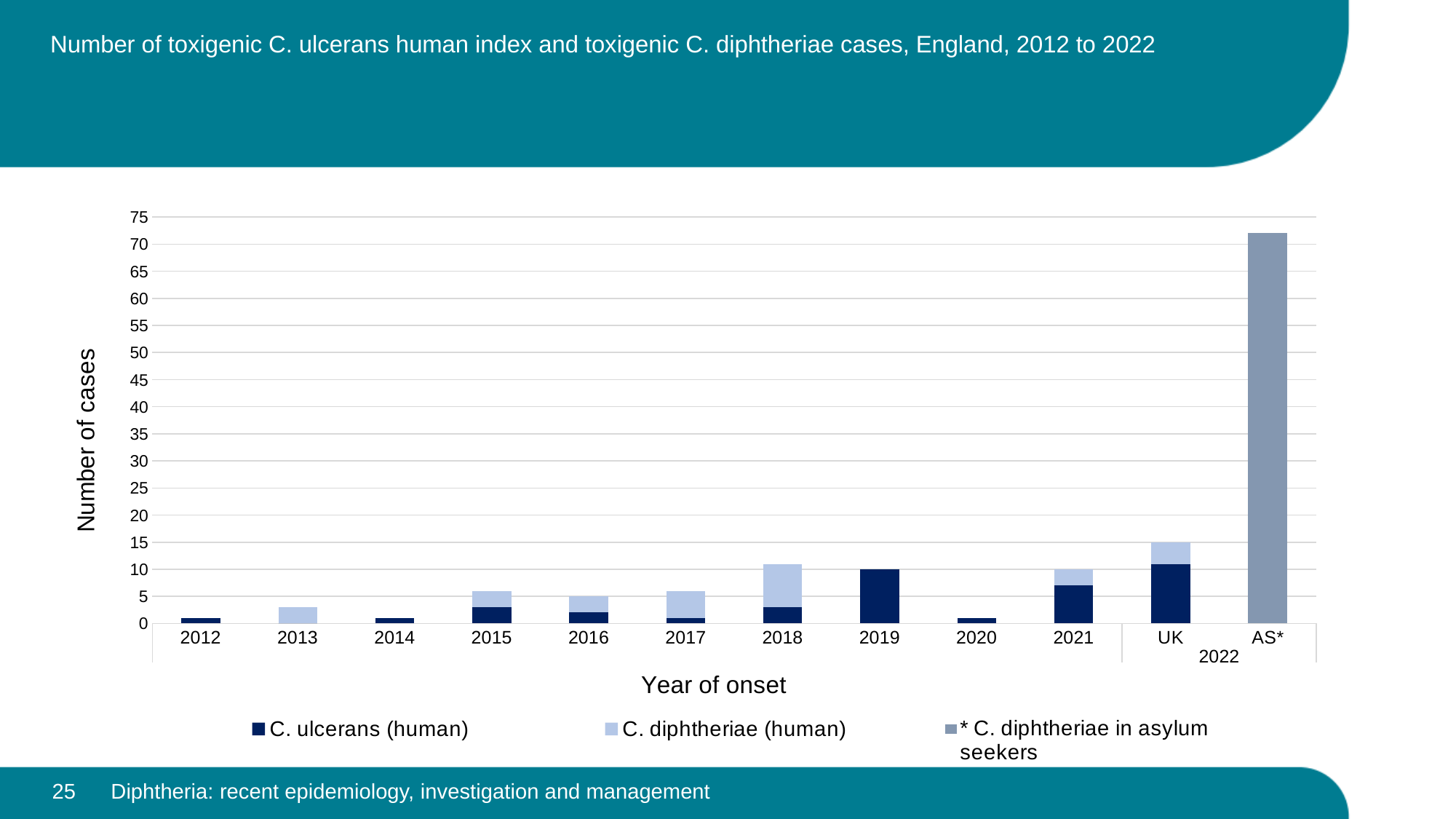
What kind of chart is shown on the slide? bar chart How many series does the legend list? 3 Is the value for the AS* 2022 bar greater or less than 70? greater What is the title of the y axis? Number of cases Which year has the larger total number of cases, 2019 or 2020? 2019 Is the total for the UK 2022 bar greater or less than 10? greater What is the number of C. ulcerans (human) cases in 2019? 10 Which bar is the highest in the chart? AS* 2022 Which year has the larger total number of cases, 2017 or 2018? 2018 What is the title of the x axis? Year of onset How many bars are plotted along the x axis? 12 Is the total for 2013 greater or less than 5? less